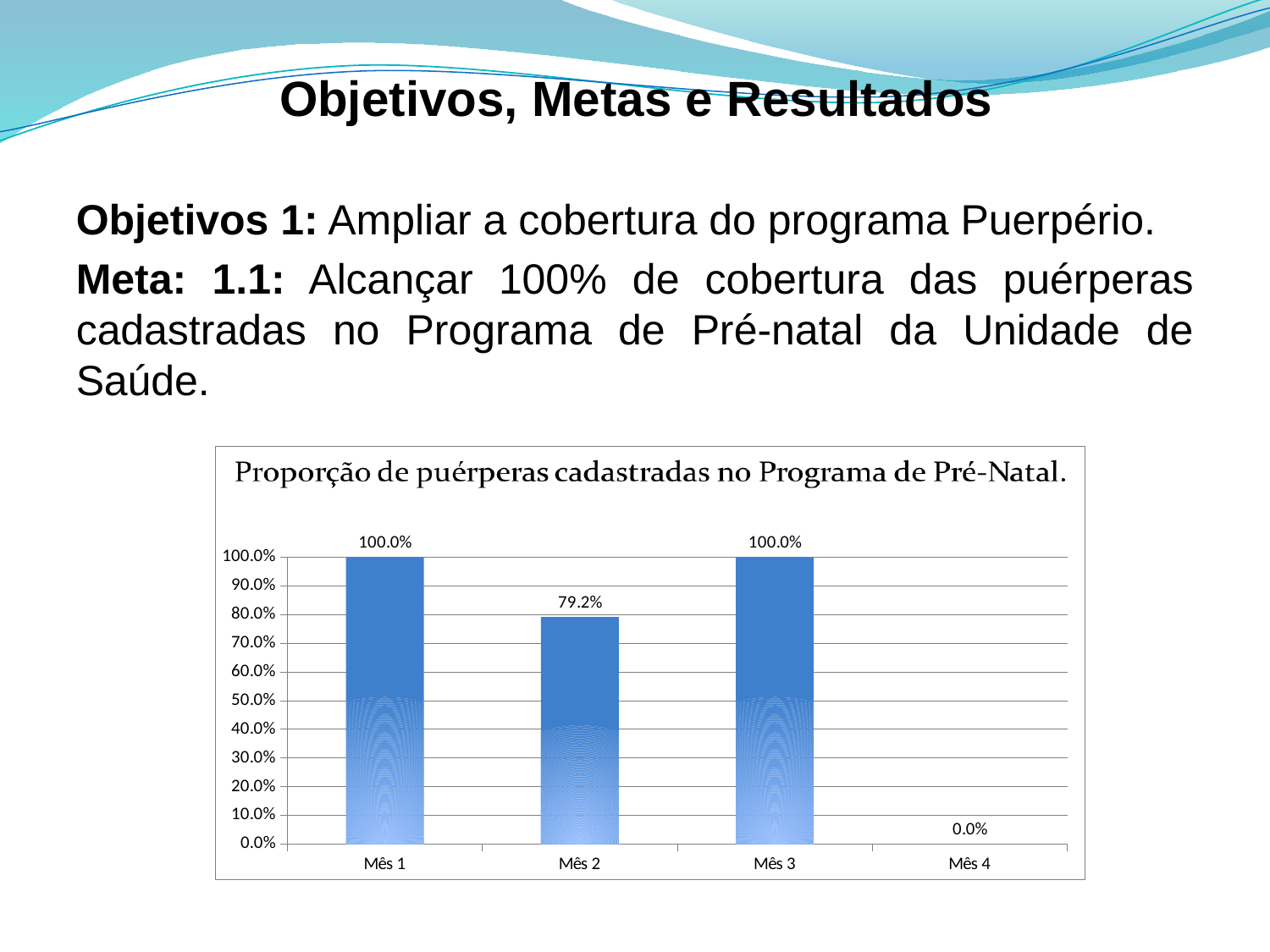
What is the value for Mês 2? 79.2% What kind of chart is shown on the slide? bar chart Which category has the lowest value? Mês 4 What is the difference between the values for Mês 3 and Mês 4? 100.0% What is the title of the chart? Proporção de puérperas cadastradas no Programa de Pré-Natal. What is the difference between the values for Mês 1 and Mês 2? 20.8% How many categories have a value of 100.0%? 2 Which is larger, the value for Mês 2 or the value for Mês 3? Mês 3 How many categories are shown on the x axis? 4 Is the value for Mês 2 greater or less than 70.0%? greater What is the value for Mês 1? 100.0% What is the value for Mês 4? 0.0%